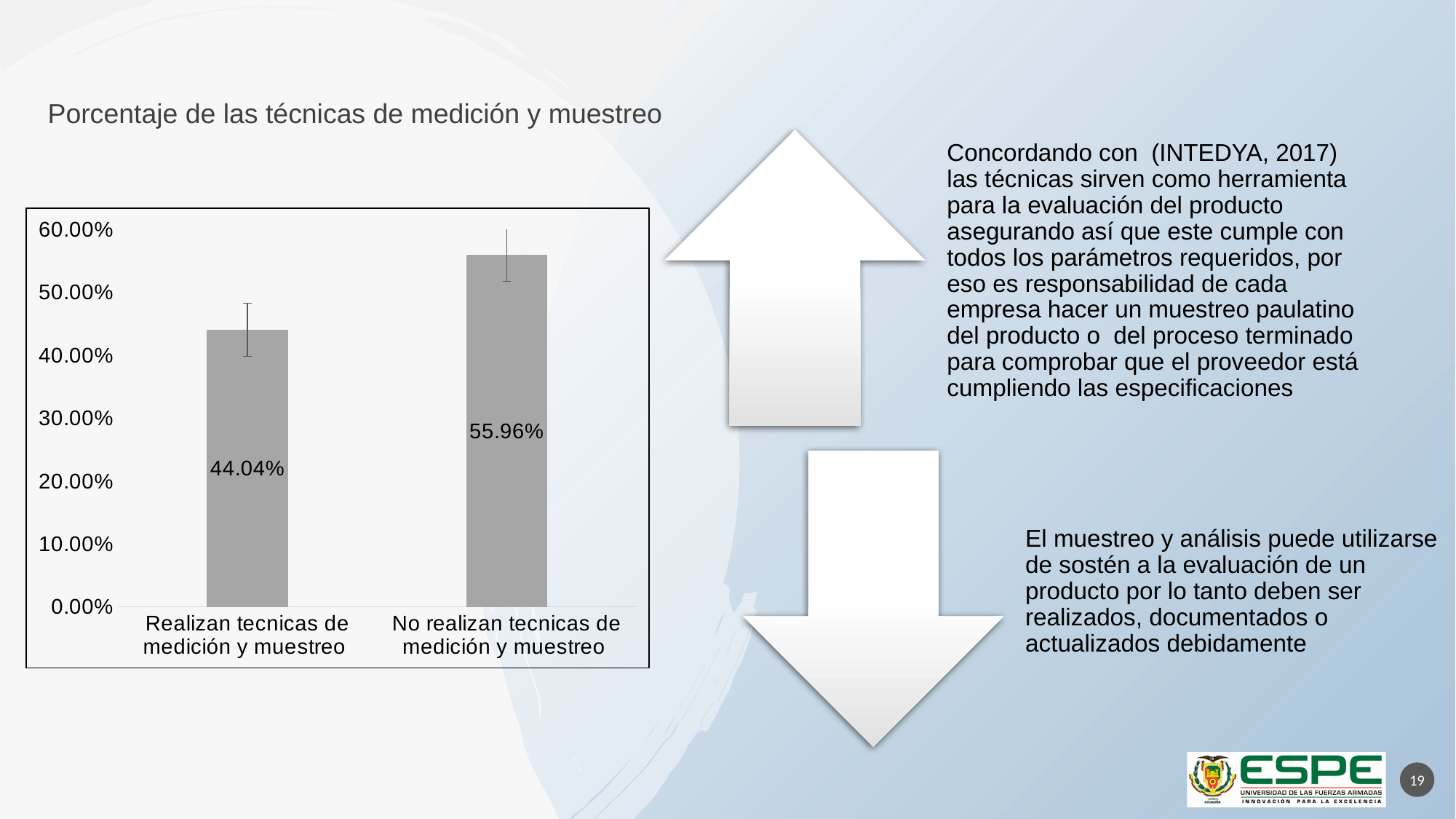
How many categories are shown on the x axis of the chart? 2 What is the title shown above the chart? Porcentaje de las técnicas de medición y muestreo What is the difference between the value for "No realizan tecnicas de medición y muestreo" and the value for "Realizan tecnicas de medición y muestreo"? 11.92% What is the value for "Realizan tecnicas de medición y muestreo"? 44.04% Which is larger: the value for "Realizan tecnicas de medición y muestreo" or the value for "No realizan tecnicas de medición y muestreo"? No realizan tecnicas de medición y muestreo Is the value for "No realizan tecnicas de medición y muestreo" greater or less than 50.00%? greater Is the value for "Realizan tecnicas de medición y muestreo" greater or less than 50.00%? less What is the total of the two values shown in the chart? 100.00% What kind of chart is shown on the slide? bar chart Which category has the lowest value? Realizan tecnicas de medición y muestreo Which category has the highest value? No realizan tecnicas de medición y muestreo What is the value for "No realizan tecnicas de medición y muestreo"? 55.96%